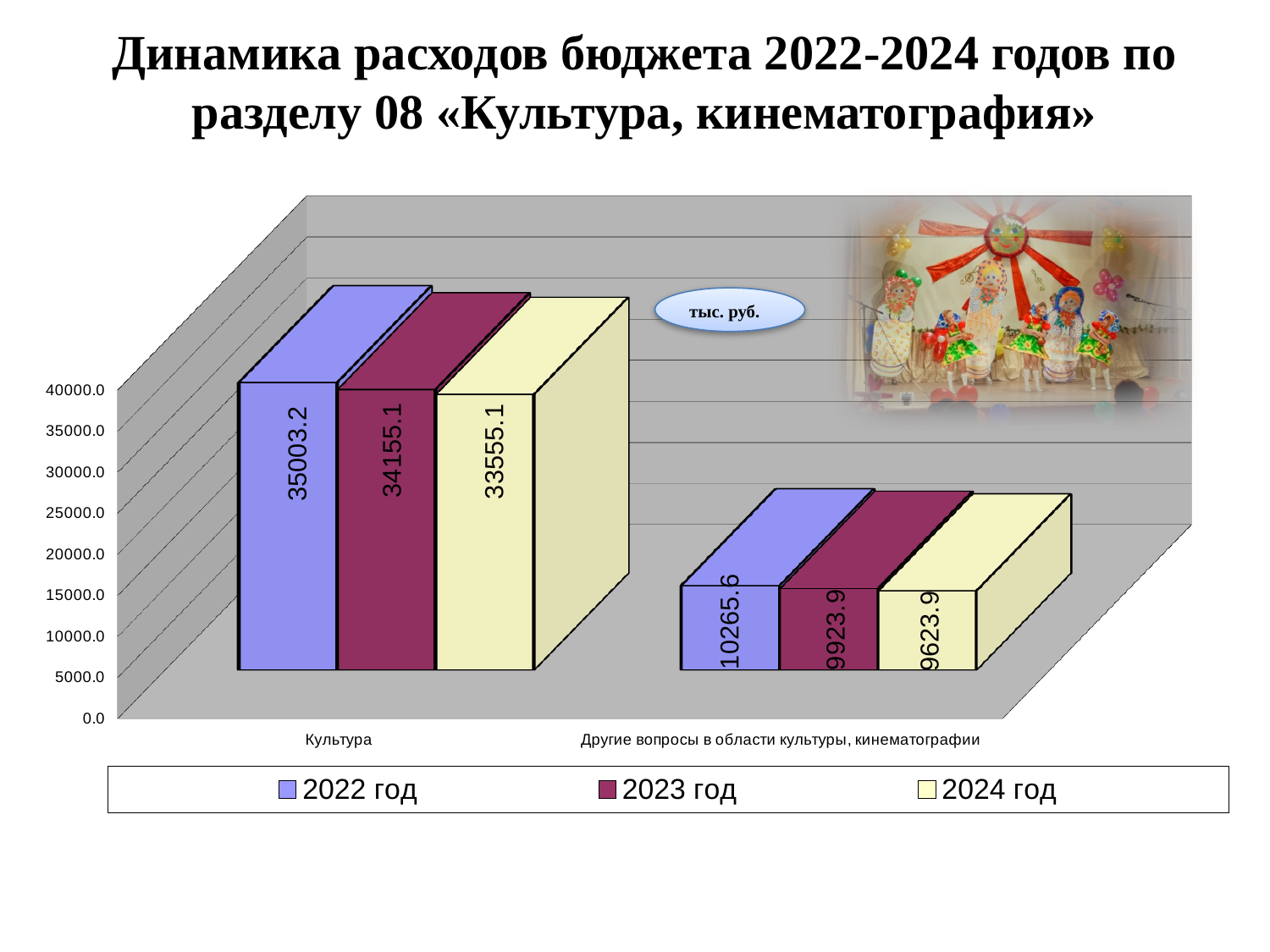
What is the value for 2022 год in the Культура category? 35003.2 What is the difference between the 2023 год and 2024 год values in the category Другие вопросы в области культуры, кинематографии? 300.0 What kind of chart is shown on the slide? Bar chart Which year has the lowest value in the category Другие вопросы в области культуры, кинематографии? 2024 год What is the difference between the 2022 год and 2023 год values in the Культура category? 848.1 What is the value for 2023 год in the category Другие вопросы в области культуры, кинематографии? 9923.9 What is the value for 2024 год in the category Другие вопросы в области культуры, кинематографии? 9623.9 Which is larger: the 2022 год value for Культура or the 2022 год value for Другие вопросы в области культуры, кинематографии? Культура Do the values for the Культура category rise or fall from 2022 год to 2024 год? Fall What is the value for 2024 год in the Культура category? 33555.1 How many series does the legend list? 3 Which year has the highest value in the Культура category? 2022 год